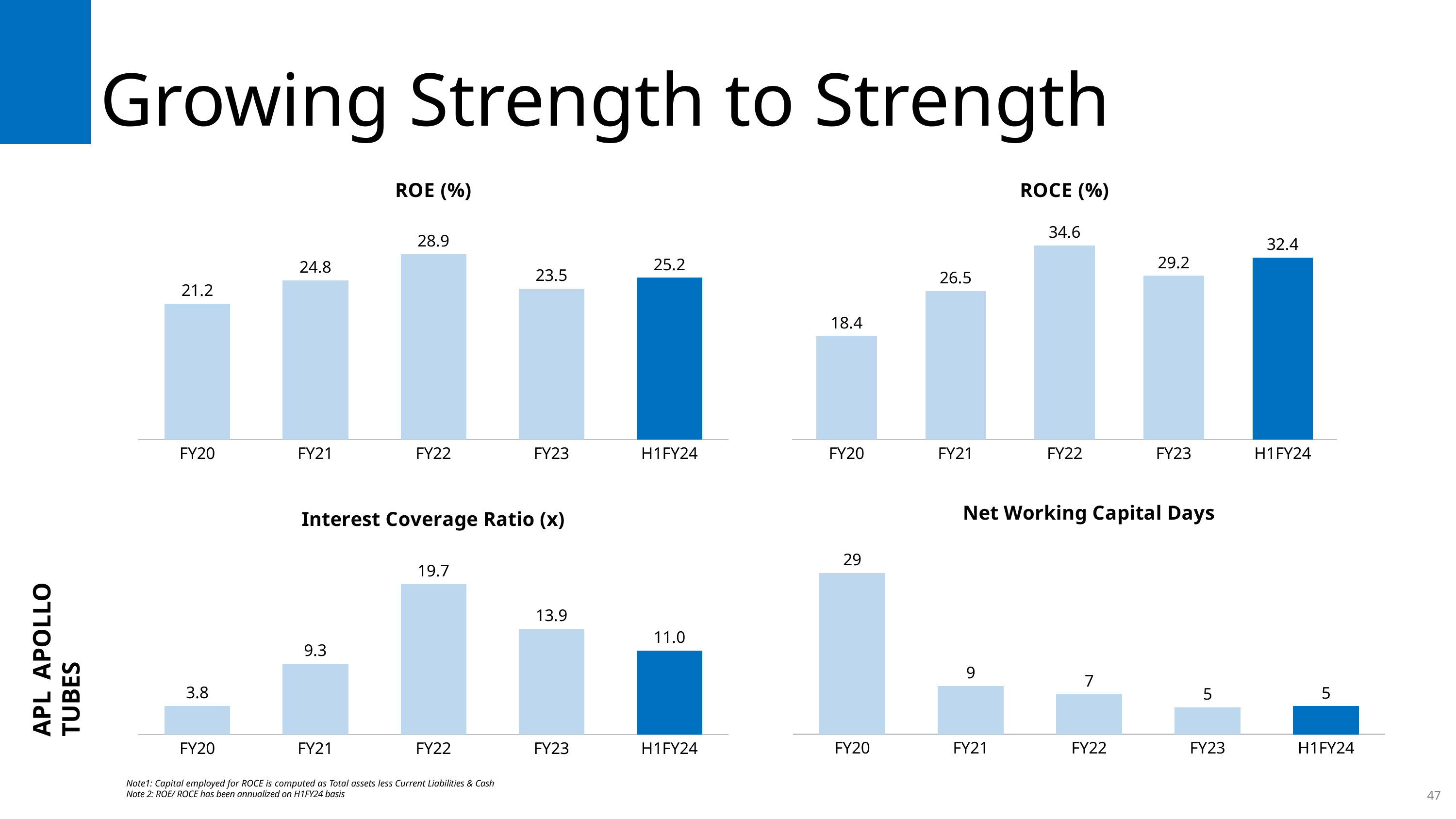
In the ROE (%) chart, how many periods are shown? 5 In the Interest Coverage Ratio (x) chart, which bar is shown in a darker blue than the others? H1FY24 In the Net Working Capital Days chart, do the values generally rise or fall from FY20 to H1FY24? Fall In the Interest Coverage Ratio (x) chart, which period has the highest value? FY22 In the Interest Coverage Ratio (x) chart, what is the difference between FY22 and FY23? 5.8 In the Net Working Capital Days chart, which is larger, FY21 or FY22? FY21 In the ROE (%) chart, what is the difference between FY21 and FY20? 3.6 In the Net Working Capital Days chart, what is the value for FY20? 29 In the ROE (%) chart, what is the value for FY22? 28.9 In the ROCE (%) chart, what is the value for H1FY24? 32.4 What kind of chart is the ROCE (%) chart? Bar chart In the ROCE (%) chart, which period has the lowest value? FY20